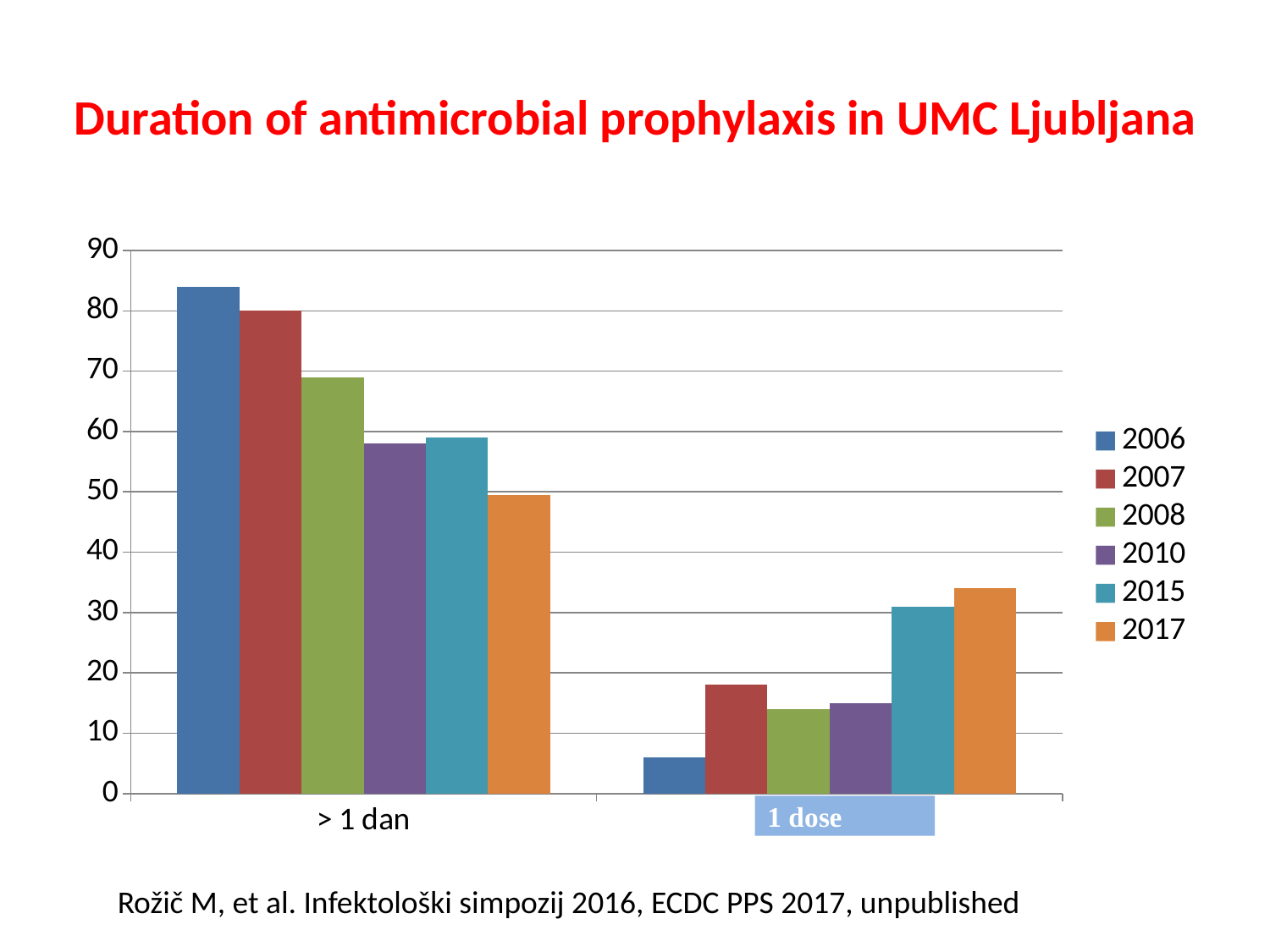
In the "> 1 dan" category, which year has the highest bar? 2006 How many series does the legend list? 6 In the "1 dose" category, which year has the highest bar? 2017 What kind of chart is shown on the slide? bar chart In the "1 dose" category, which year has the lowest bar? 2006 In the "> 1 dan" category, which year has the lowest bar? 2017 Is the value for 2008 in the "> 1 dan" category greater or less than 70? less Is the value for 2006 in the "1 dose" category greater or less than 10? less In the "1 dose" category, which is larger: the value for 2006 or the value for 2007? 2007 Is the value for 2006 in the "> 1 dan" category greater or less than 80? greater How many categories are shown on the x axis? 2 What is the title of the chart on the slide? Duration of antimicrobial prophylaxis in UMC Ljubljana